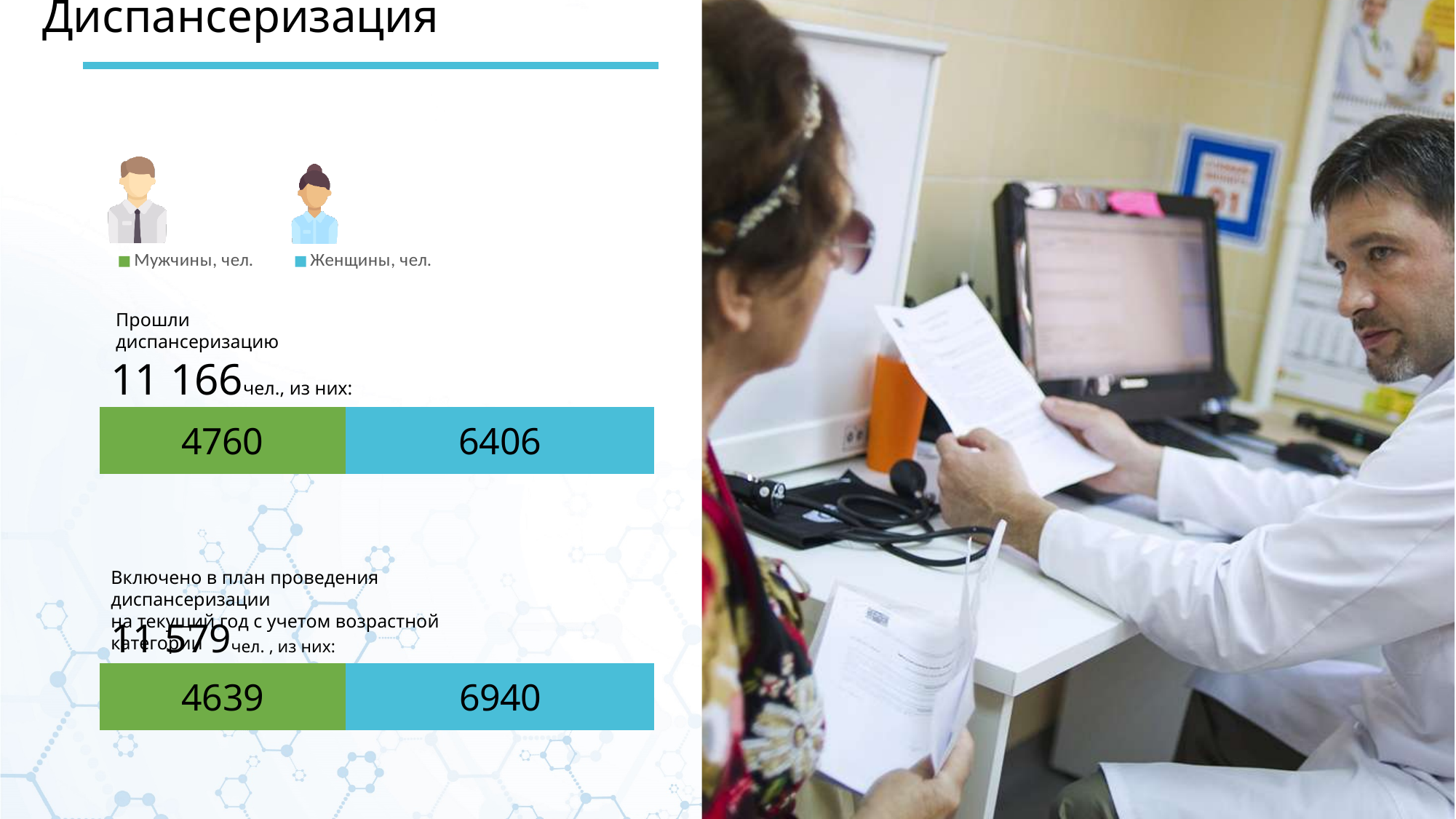
In the lower chart (Включено в план проведения диспансеризации), what is the value for Женщины, чел.? 6940 In the 'Прошли диспансеризацию' chart, what is the difference between the values for Женщины and Мужчины? 1646 In the 'Прошли диспансеризацию' chart, what is the total of the stacked bar? 11 166 Which colour represents Мужчины, чел. in the charts? Green In the 'Прошли диспансеризацию' chart, what is the value for Женщины, чел.? 6406 In the 'Прошли диспансеризацию' chart, what is the value for Мужчины, чел.? 4760 In the lower chart (Включено в план проведения диспансеризации), what is the difference between the values for Женщины and Мужчины? 2301 What kind of chart is used to show the 'Прошли диспансеризацию' data? Stacked bar chart In the 'Прошли диспансеризацию' chart, which series has the larger value, Мужчины or Женщины? Женщины In the lower chart (Включено в план проведения диспансеризации), what is the value for Мужчины, чел.? 4639 In the lower chart (Включено в план проведения диспансеризации), what is the total of the stacked bar? 11 579 How many series does the legend list for the charts on the slide? 2